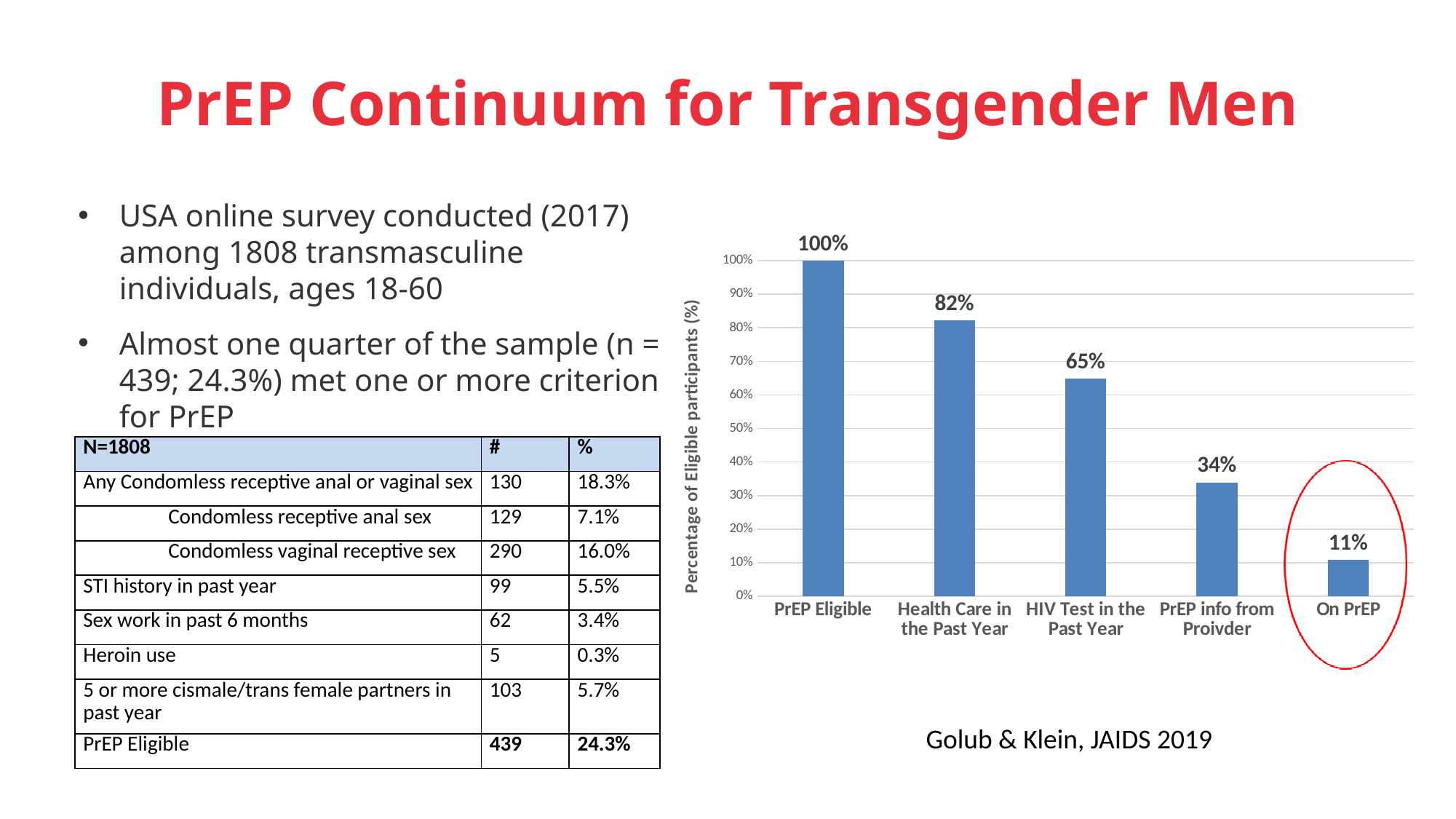
What is the difference between the values for PrEP info from Proivder and On PrEP? 23% What is the value for HIV Test in the Past Year? 65% What is the value for Health Care in the Past Year? 82% What is the difference between the values for Health Care in the Past Year and HIV Test in the Past Year? 17% What kind of chart is shown on the slide? bar chart How many categories are shown on the x axis of the chart? 5 Which category has the lowest value? On PrEP What is the value for On PrEP? 11% What is the value for PrEP info from Proivder? 34% Do the values rise or fall from left to right along the x axis? fall Which is larger, the value for HIV Test in the Past Year or the value for PrEP info from Proivder? HIV Test in the Past Year Which category has the highest value? PrEP Eligible